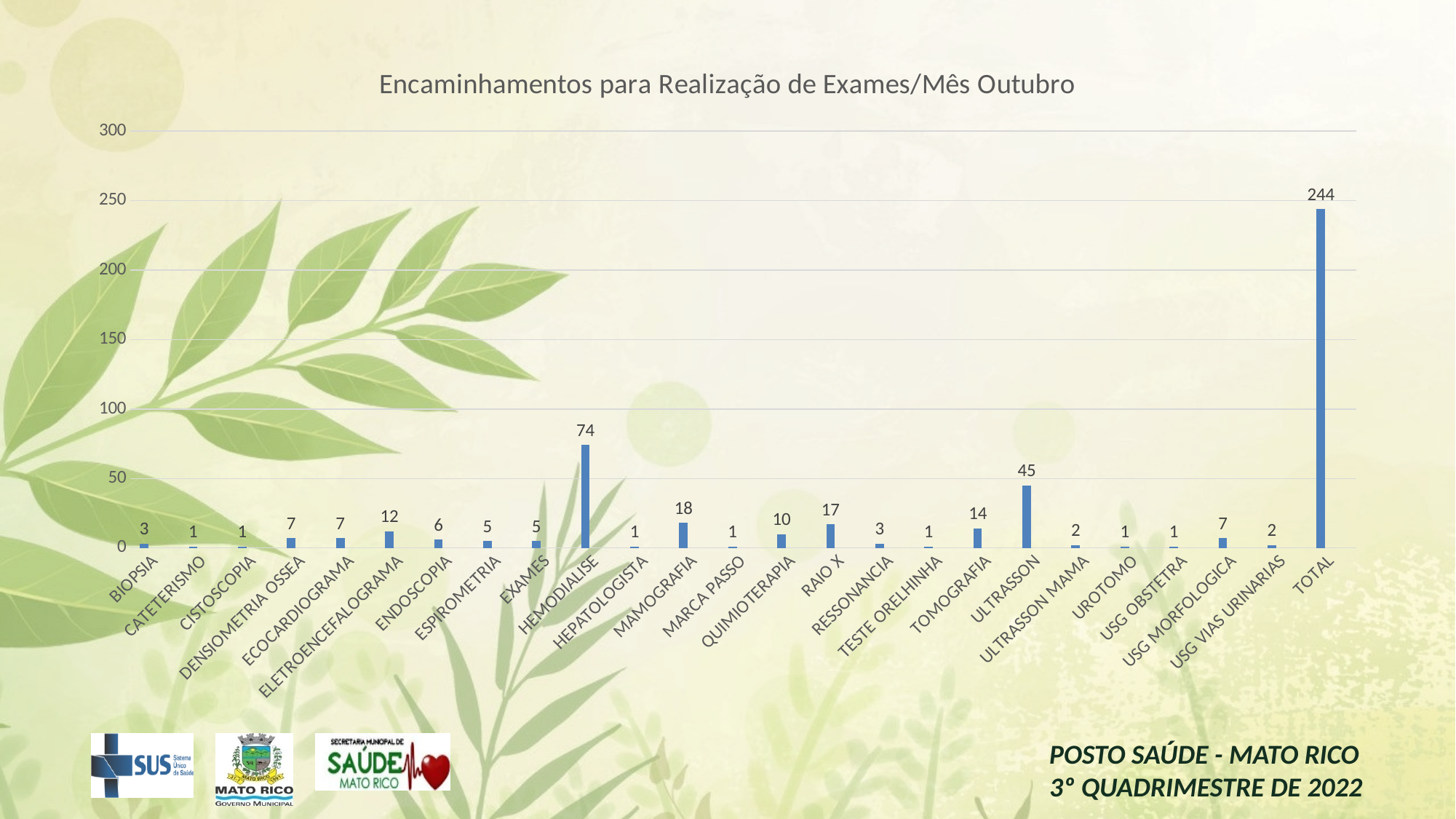
What is the title of the chart? Encaminhamentos para Realização de Exames/Mês Outubro What is the difference between the values for HEMODIALISE and ULTRASSON? 29 What kind of chart is shown on the slide? Bar chart What is the value for QUIMIOTERAPIA? 10 Which is larger, the value for RAIO X or the value for TOMOGRAFIA? RAIO X How many bars are plotted in the chart, including TOTAL? 25 What is the value shown for the TOTAL bar? 244 Is the value for TOTAL greater or less than 200? greater Excluding the TOTAL bar, which category has the highest value? HEMODIALISE What is the value for MAMOGRAFIA? 18 What is the value for ULTRASSON? 45 What is the value for HEMODIALISE? 74